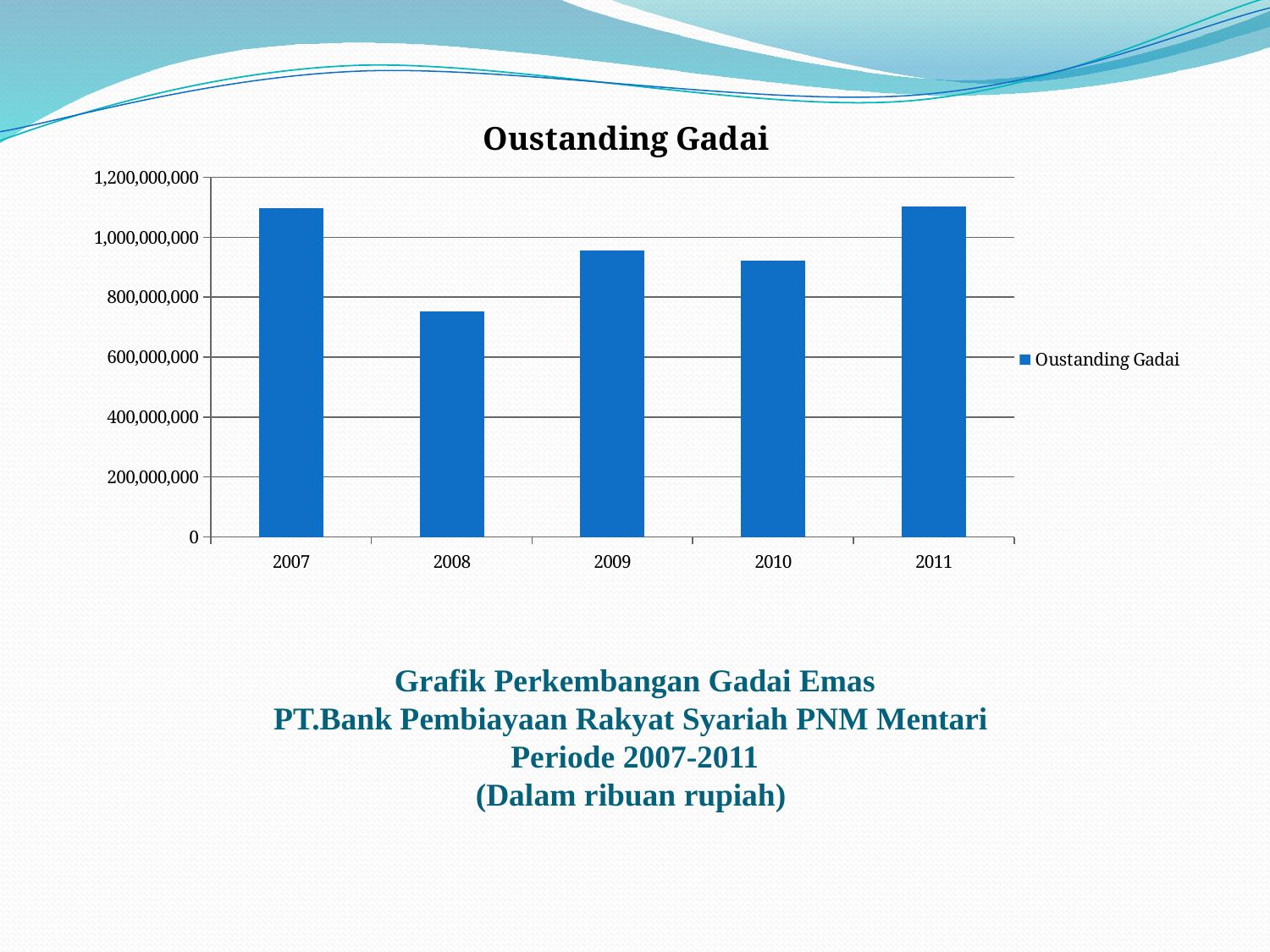
Which is larger, the value for 2007 or the value for 2010? 2007 Which year has the lowest Oustanding Gadai value? 2008 Is the value for 2007 greater or less than 1,000,000,000? greater What kind of chart is shown on the slide? bar chart Is the value for 2009 greater or less than 800,000,000? greater What is the title of the chart? Oustanding Gadai Which is larger, the value for 2009 or the value for 2008? 2009 How many years are shown on the x axis of the chart? 5 How many series does the legend list? 1 Is the value for 2010 greater or less than 1,000,000,000? less Does the value rise or fall from 2007 to 2008? fall